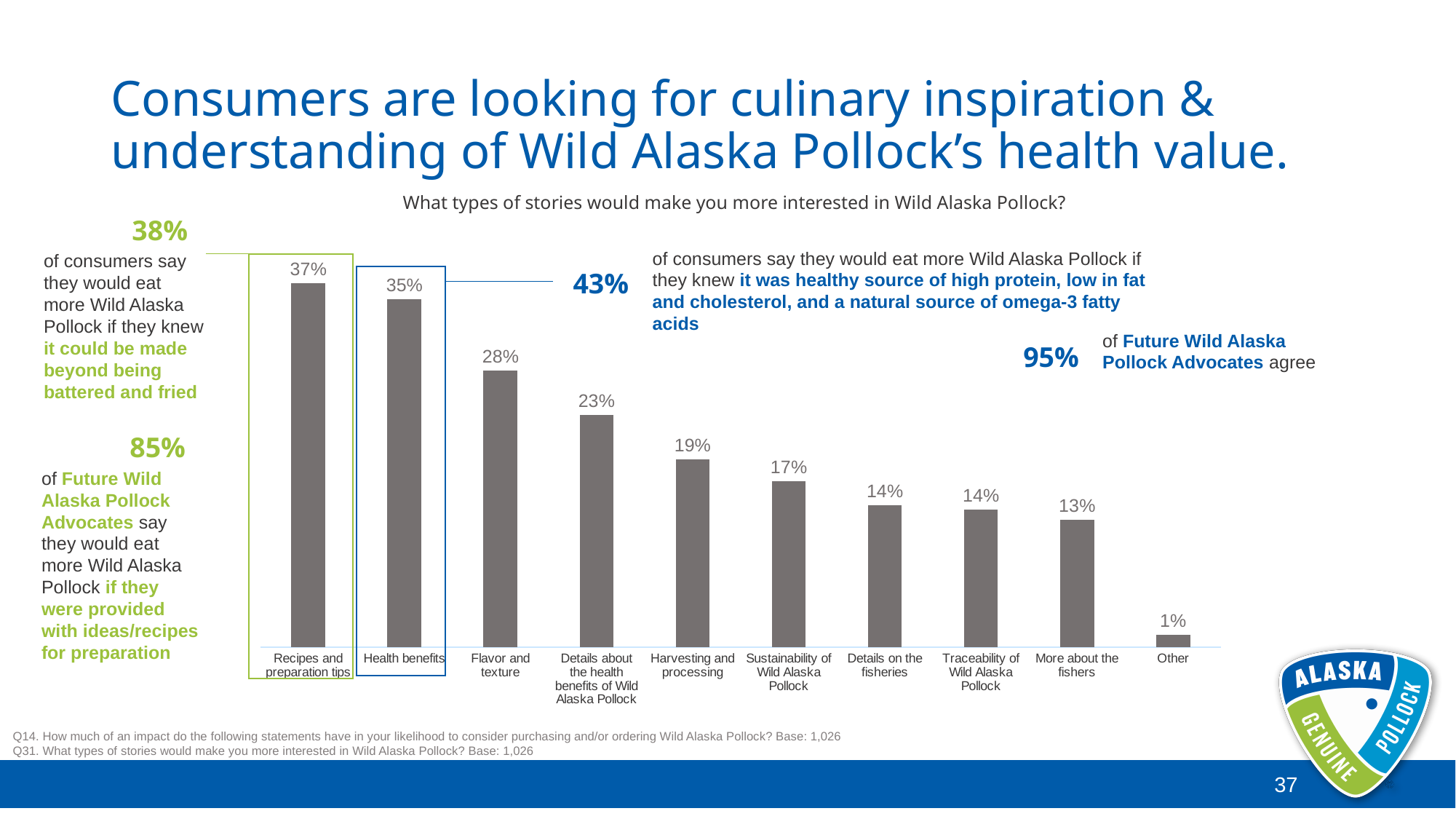
Which category has the lowest value in the chart? Other Do the values rise or fall moving from left to right across the chart? Fall What value is shown for 'Flavor and texture'? 28% What is the difference between the values for 'Recipes and preparation tips' and 'Health benefits'? 2% What percentage of respondents said stories about recipes and preparation tips would make them more interested in Wild Alaska Pollock? 37% What is the difference between 'Flavor and texture' and 'Details about the health benefits of Wild Alaska Pollock'? 5% What type of chart is shown on the slide? Bar chart What percentage is shown for 'Harvesting and processing'? 19% Which is larger: the value for 'Sustainability of Wild Alaska Pollock' or 'More about the fishers'? Sustainability of Wild Alaska Pollock How many story categories are shown in the chart? 10 Which story type has the highest value in the chart? Recipes and preparation tips What is the value shown for 'Health benefits' in the chart? 35%